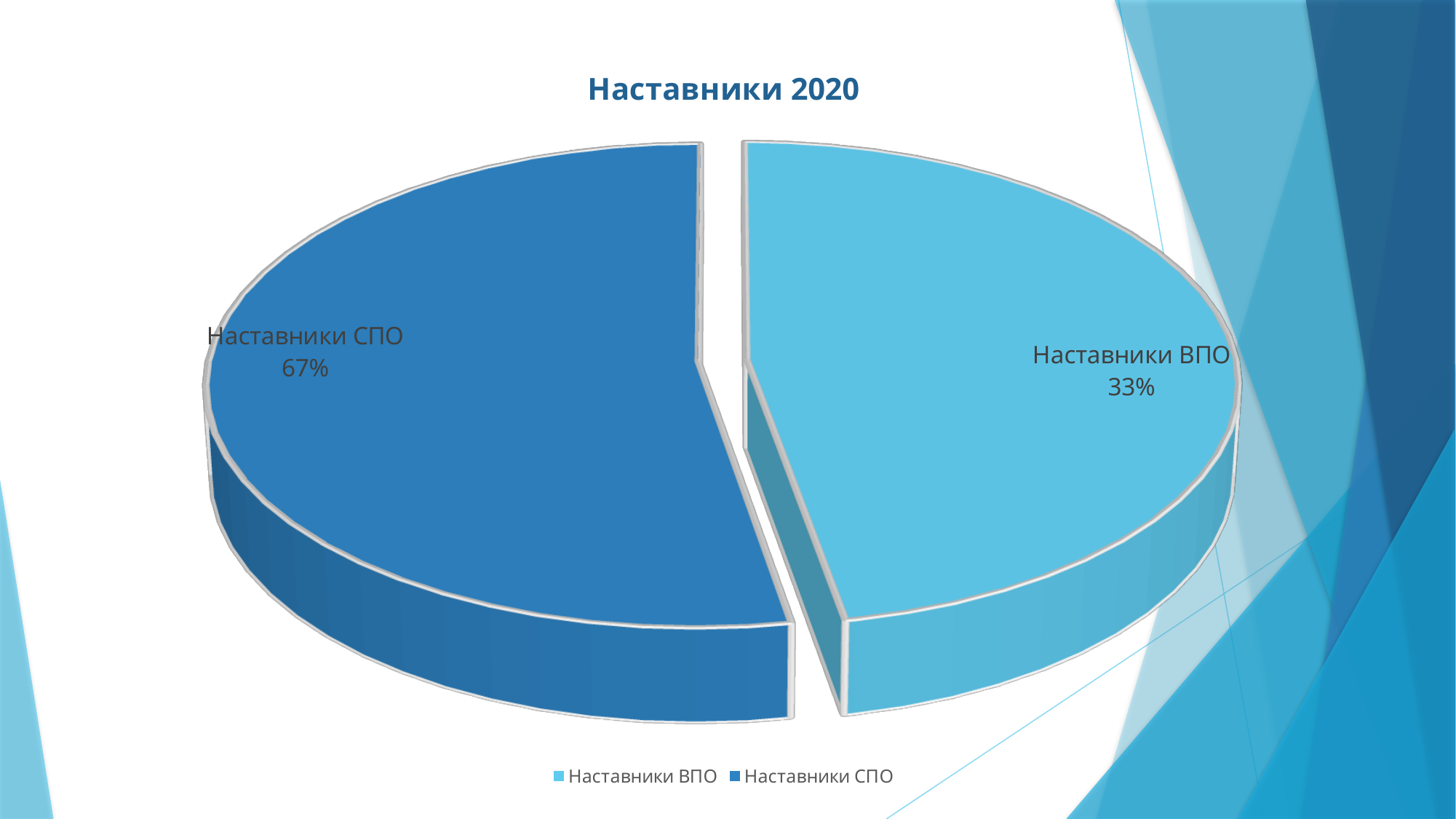
Which category has the smallest share of the pie? Наставники ВПО Which category has the largest share of the pie? Наставники СПО Which slice is shown in the lighter blue colour? Наставники ВПО How many entries does the legend list? 2 What share of the pie does Наставники СПО represent? 67% How many slices does the pie chart have? 2 What type of chart is shown on the slide? pie chart What share of the pie does Наставники ВПО represent? 33% What is the title of the chart? Наставники 2020 What is the difference in percentage points between Наставники СПО and Наставники ВПО? 34 Which is larger, the share for Наставники ВПО or the share for Наставники СПО? Наставники СПО